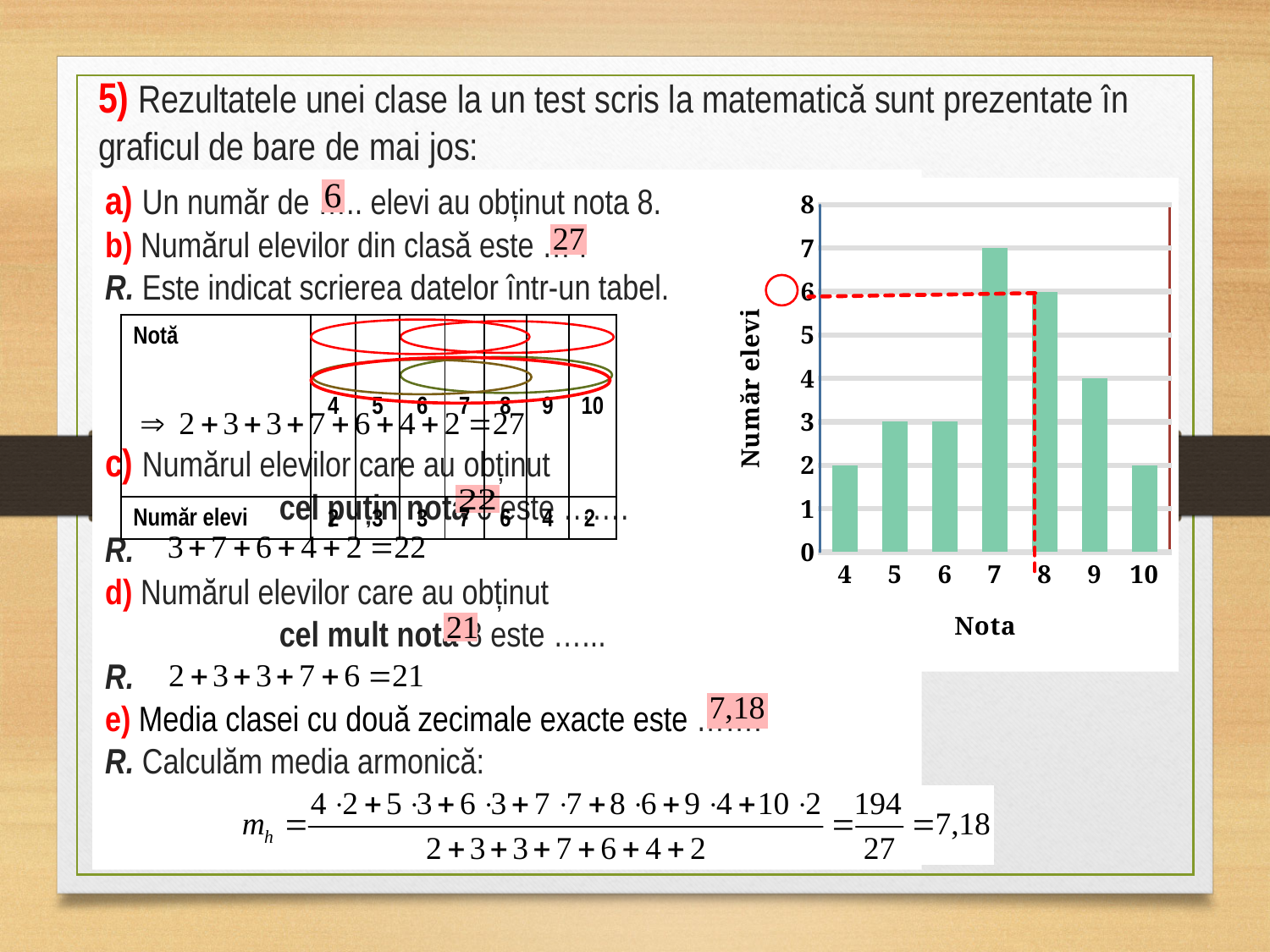
What kind of chart is shown on the slide? bar chart Is the number of students with grade 7 greater or less than 5? greater How many students obtained grade 7 according to the chart? 7 Which has more students: grade 9 or grade 10? grade 9 How many students obtained grade 9 according to the chart? 4 How many students obtained grade 4 according to the chart? 2 What is the label of the horizontal axis of the chart? Nota What is the label of the vertical axis of the chart? Număr elevi How many students obtained grade 8 according to the chart? 6 Which grade (Nota) has the highest number of students? 7 What is the difference between the number of students with grade 7 and the number with grade 8? 1 How many grade categories are shown on the x axis of the chart? 7